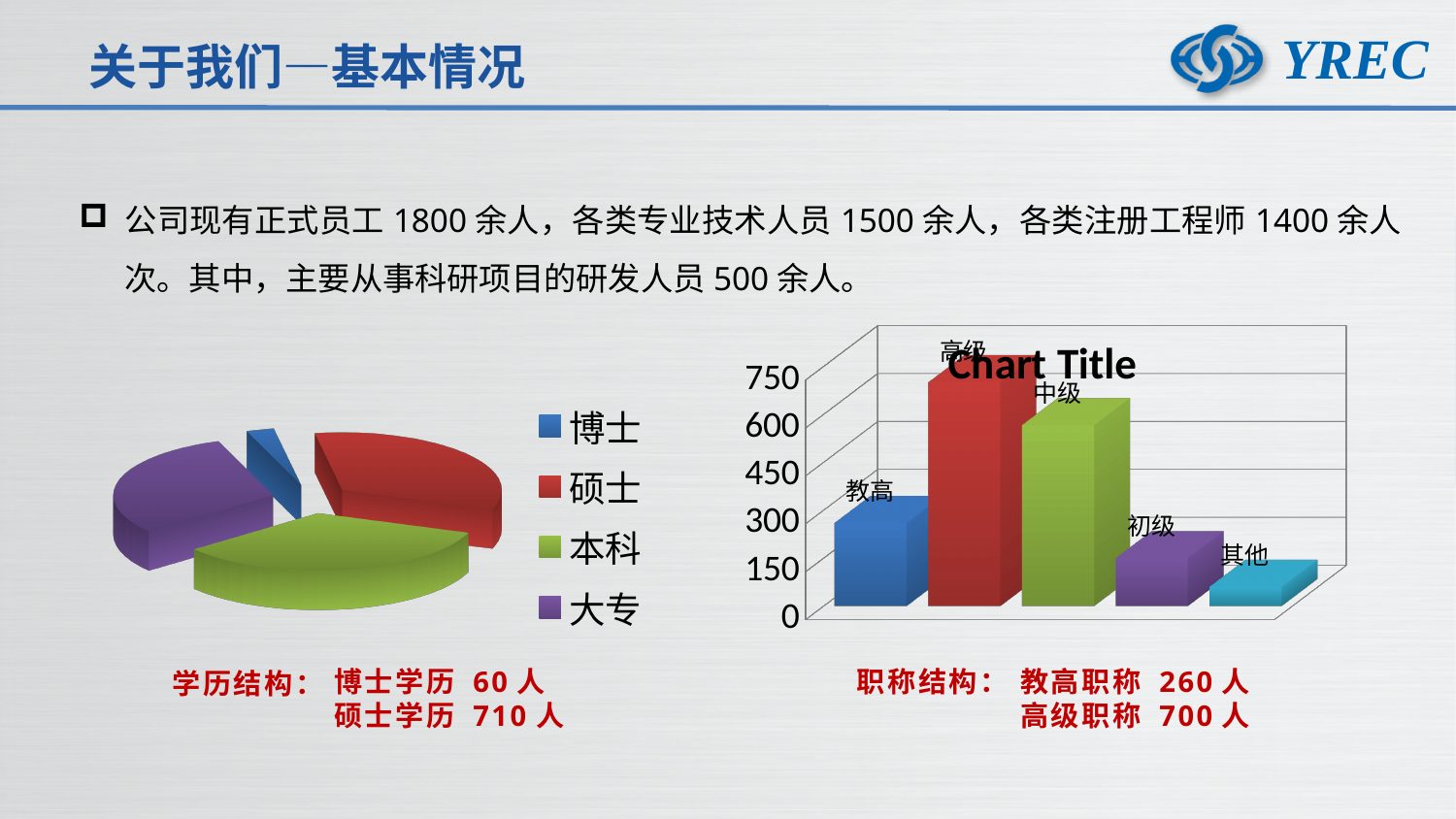
In the bar chart on the right, is the value for 高级 greater or less than 600? greater In the bar chart on the right, is the value for 初级 greater or less than 300? less In the bar chart on the right, which category has the highest bar? 高级 What kind of chart is the chart on the right of the slide? bar chart What kind of chart is the chart on the left of the slide? pie chart How many entries does the legend of the pie chart on the left list? 4 In the pie chart on the left, what colour is the 博士 slice? blue What is the title shown on the bar chart on the right? Chart Title In the bar chart on the right, which category has the lowest bar? 其他 In the bar chart on the right, which is larger, the value for 中级 or the value for 初级? 中级 In the pie chart on the left, which category has the smallest slice? 博士 How many categories are plotted in the bar chart on the right? 5